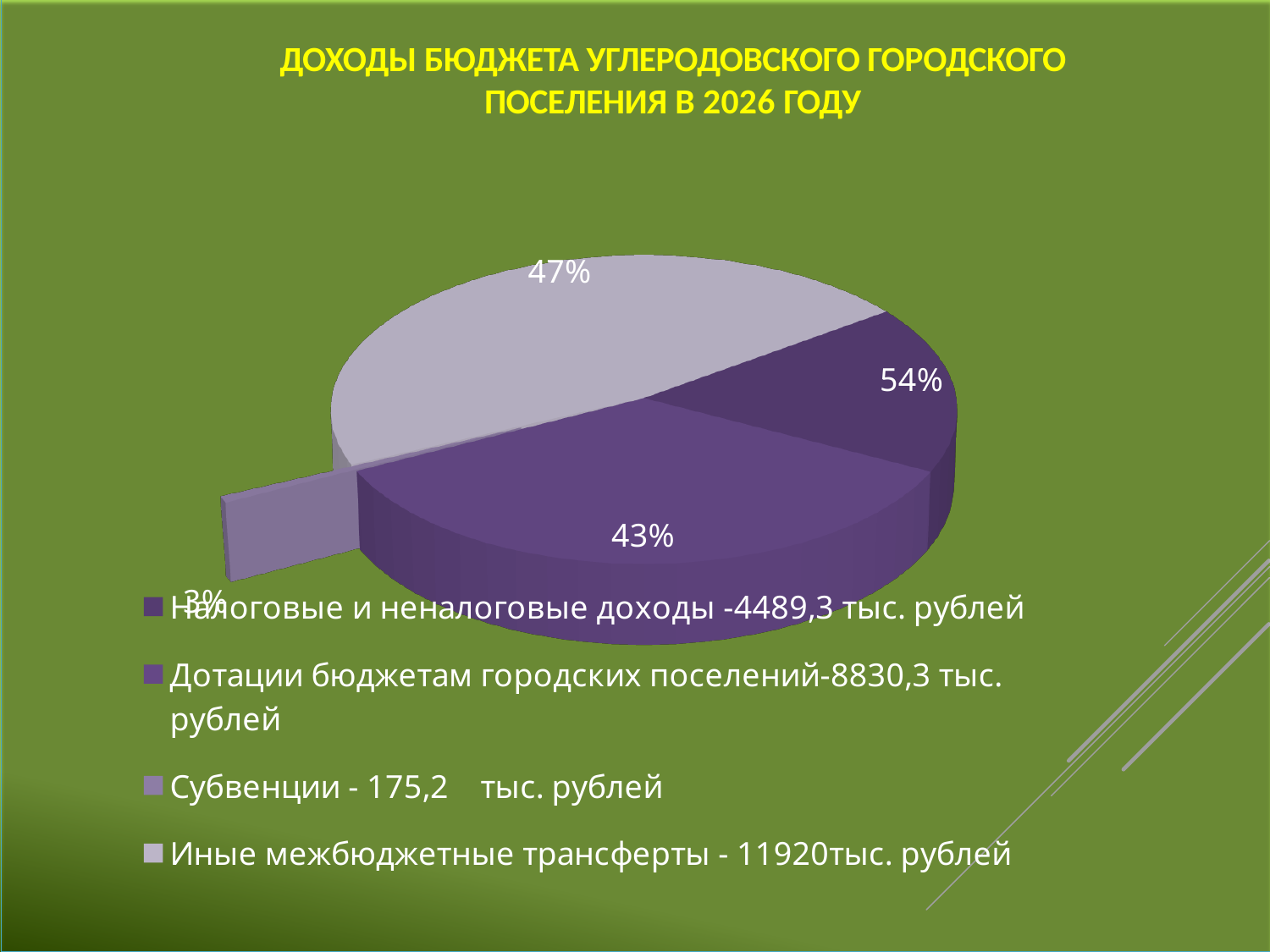
What kind of chart is shown on the slide? pie chart How many entries does the legend of the pie chart list? 4 What is the title of the chart on the slide? ДОХОДЫ БЮДЖЕТА УГЛЕРОДОВСКОГО ГОРОДСКОГО ПОСЕЛЕНИЯ В 2026 ГОДУ Which is larger: the amount for Дотации бюджетам городских поселений or for Налоговые и неналоговые доходы? Дотации бюджетам городских поселений What amount is given in the legend for Налоговые и неналоговые доходы? 4489,3 тыс. рублей What amount is given in the legend for Дотации бюджетам городских поселений? 8830,3 тыс. рублей Which legend category has the largest amount in тыс. рублей? Иные межбюджетные трансферты What amount is given in the legend for Субвенции? 175,2 тыс. рублей What amount is given in the legend for Иные межбюджетные трансферты? 11920 тыс. рублей Which legend category has the smallest amount in тыс. рублей? Субвенции What is the smallest percentage label shown on the pie chart? 3% What is the difference between the amounts for Дотации бюджетам городских поселений and Налоговые и неналоговые доходы? 4341 тыс. рублей